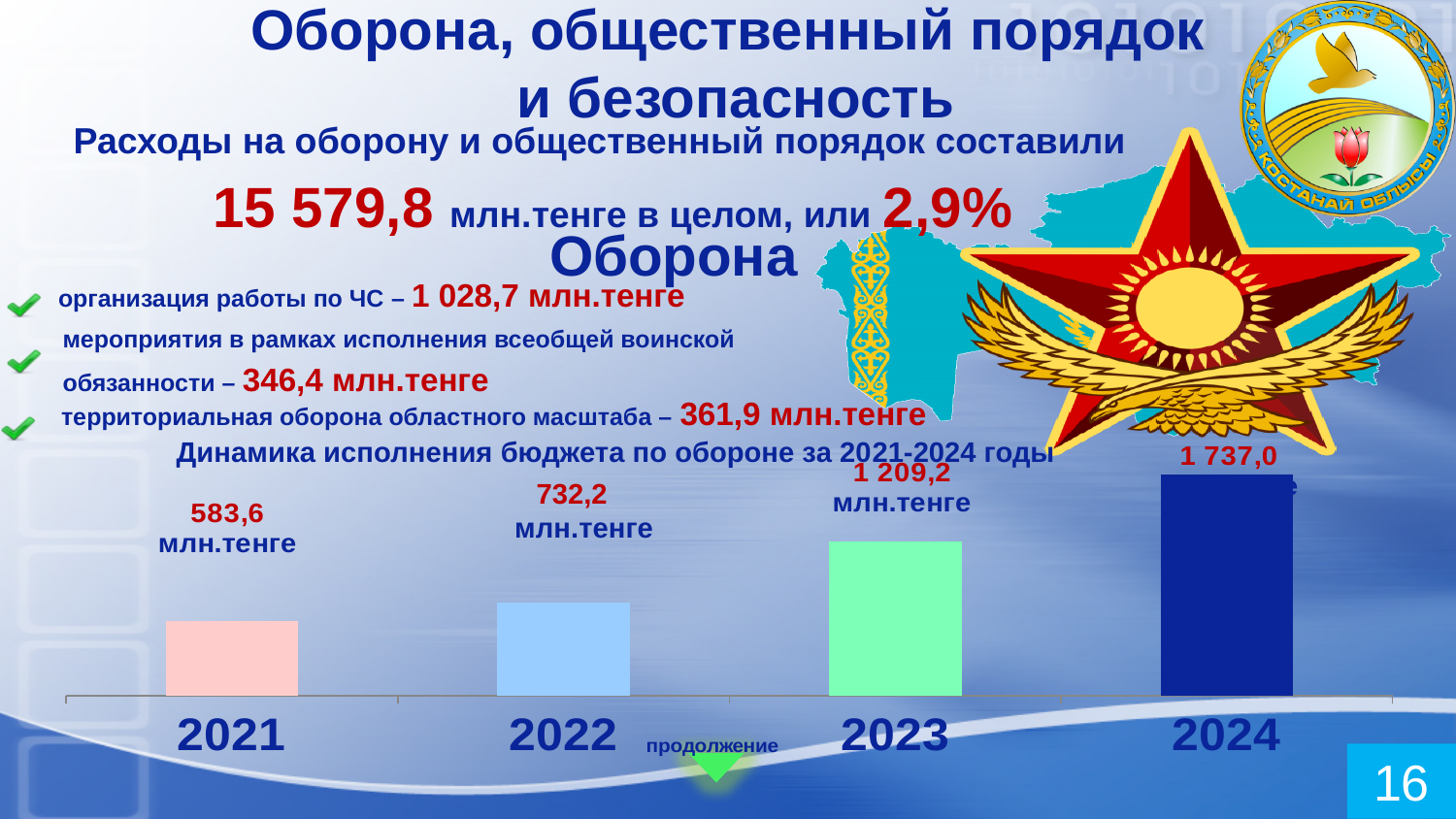
What is the value for 2021 in the chart 'Динамика исполнения бюджета по обороне за 2021-2024 годы'? 583,6 млн.тенге What is the value for 2023 in the defence budget chart? 1 209,2 млн.тенге What is the difference between the 2024 and 2023 values in the defence budget chart? 527,8 млн.тенге Which is larger in the defence budget chart, the value for 2022 or the value for 2023? 2023 Which year has the lowest value in the defence budget chart? 2021 What is the value for 2022 in the defence budget chart? 732,2 млн.тенге How many years are shown in the defence budget chart? 4 What is the value for 2024 in the defence budget chart? 1 737,0 What is the difference between the 2022 and 2021 values in the defence budget chart? 148,6 млн.тенге Do the values in the defence budget chart rise or fall from 2021 to 2024? Rise Which year has the highest value in the defence budget chart? 2024 What kind of chart is used to show the defence budget dynamics for 2021-2024? Bar chart